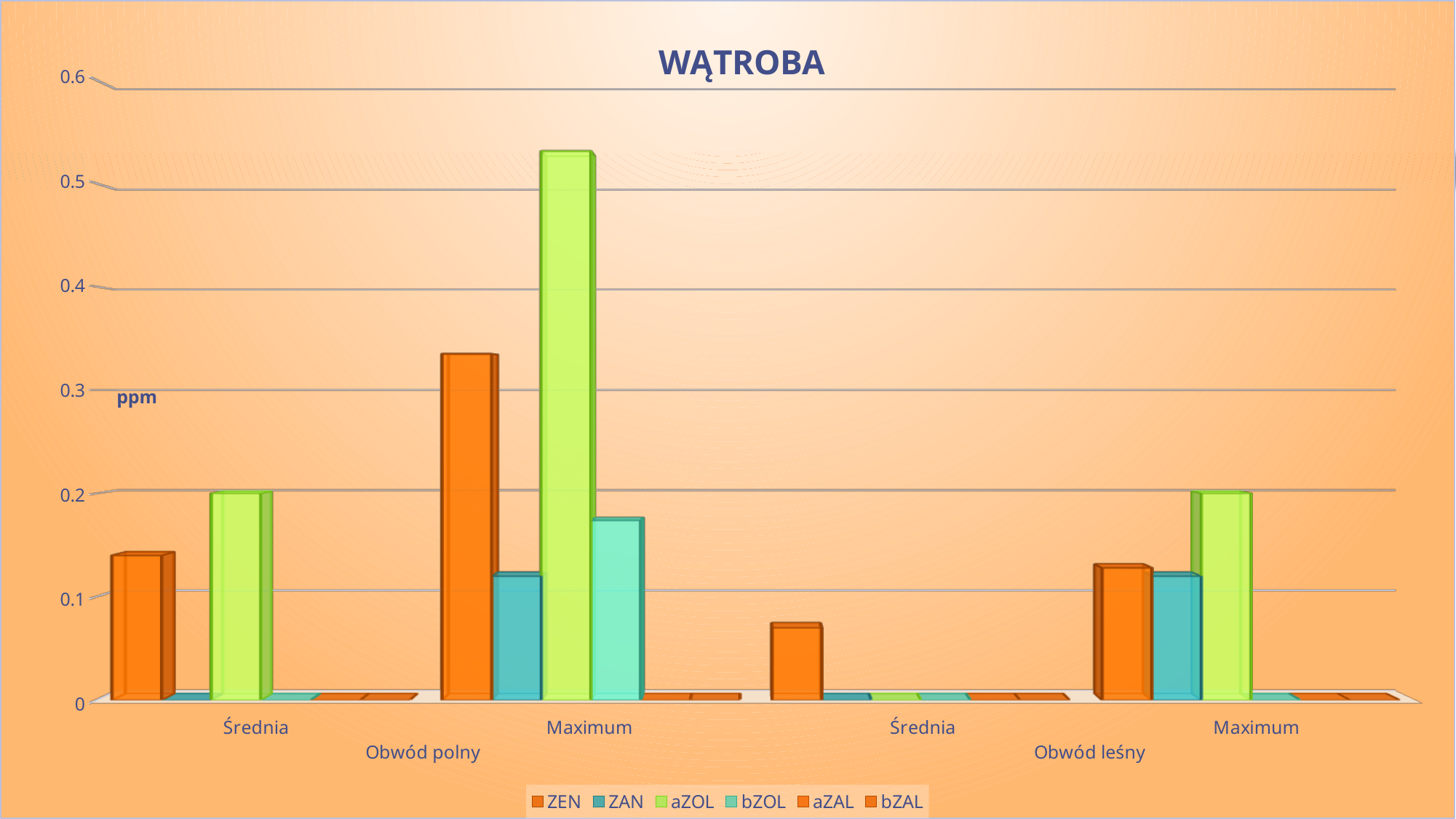
What is the title of the chart? WĄTROBA Which series has the highest value in the Maximum category of Obwód polny? aZOL In which category is the ZEN value lowest? Średnia in Obwód leśny What kind of chart is shown on the slide? bar chart Which is larger in the Maximum category of Obwód polny: ZEN or aZOL? aZOL Is the ZEN value for Maximum in Obwód polny greater or less than 0.3? greater Is the ZEN value for Średnia in Obwód leśny greater or less than 0.1? less Which is larger for ZEN: Średnia in Obwód polny or Średnia in Obwód leśny? Średnia in Obwód polny How many series does the legend list? 6 Is the aZOL value for Maximum in Obwód polny greater or less than 0.5? greater What unit is shown on the vertical axis? ppm